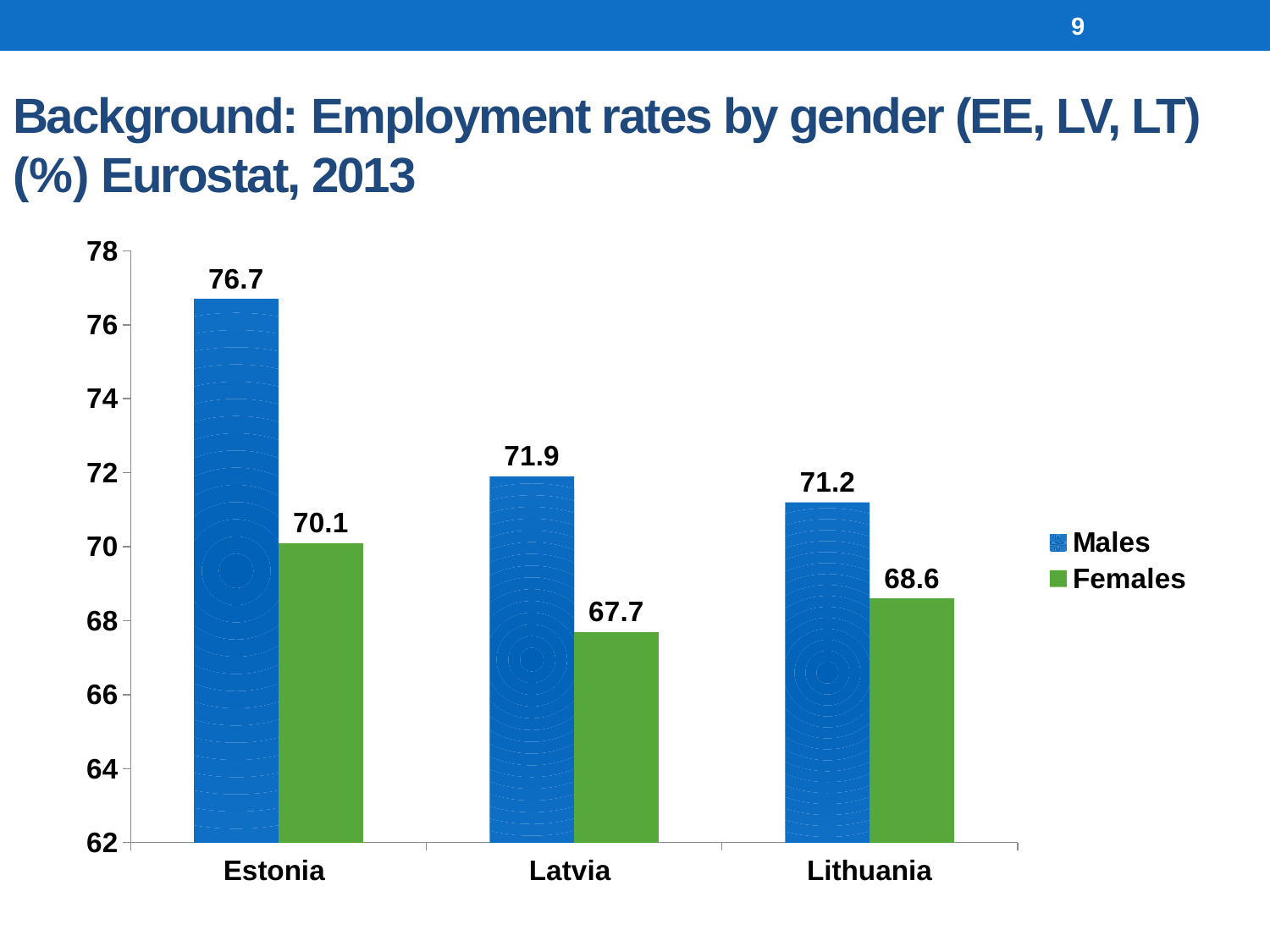
How many series does the legend list? 2 Which country has the highest male employment rate? Estonia What kind of chart is shown on the slide? bar chart What is the employment rate for females in Lithuania? 68.6 What is the difference between the male employment rates of Latvia and Lithuania? 0.7 What is the employment rate for females in Latvia? 67.7 Which country has the lowest female employment rate? Latvia Which is larger: the female employment rate in Estonia or the female employment rate in Lithuania? Estonia Is the male employment rate in Lithuania greater or less than 70? greater What is the difference between the male and female employment rates in Estonia? 6.6 How many countries are shown on the x axis? 3 What is the employment rate for males in Estonia? 76.7